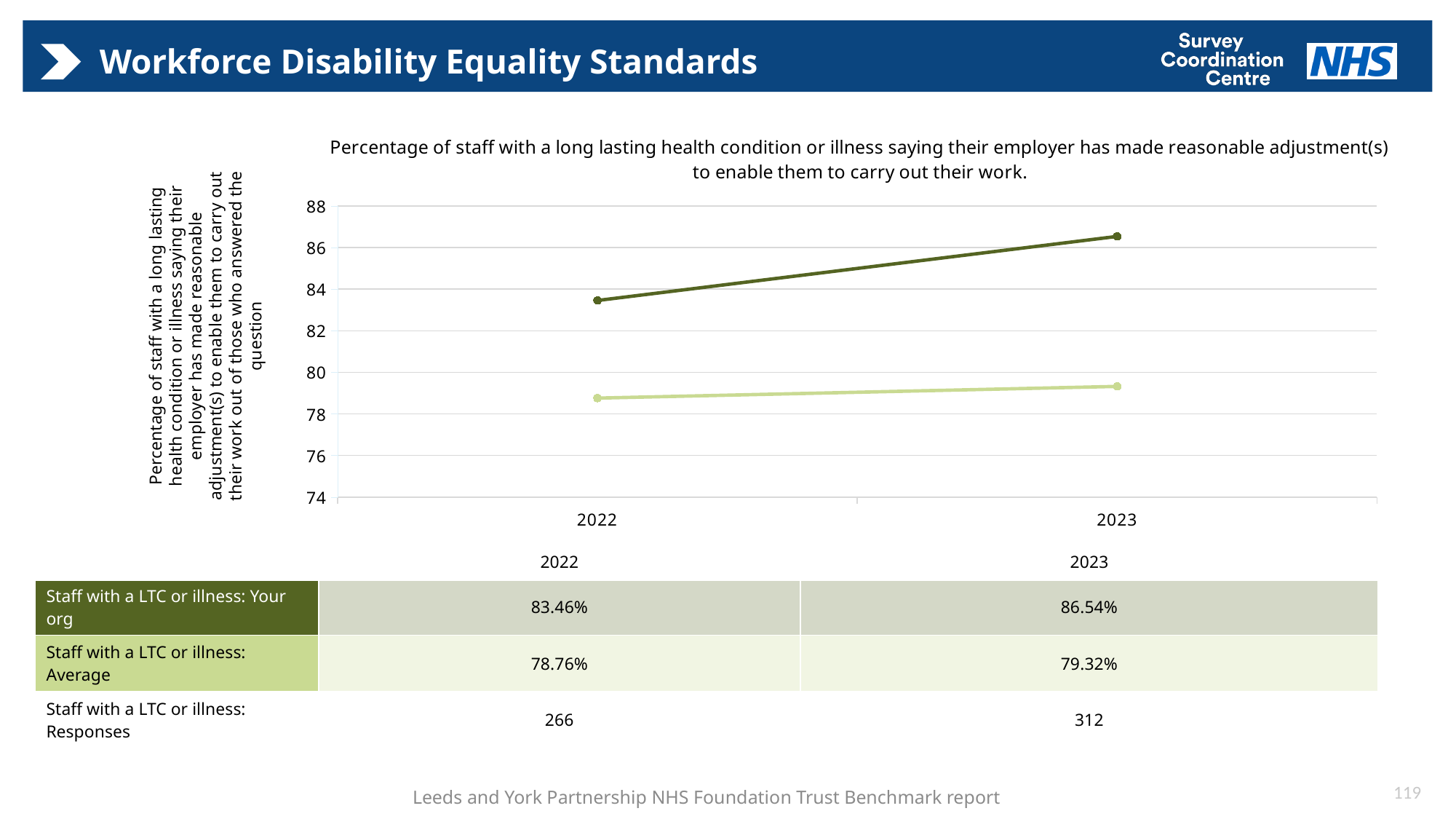
What is the value for 'Staff with a LTC or illness: Your org' in 2022? 83.46% How many responses were there for 'Staff with a LTC or illness' in 2023? 312 What is the value for 'Staff with a LTC or illness: Average' in 2023? 79.32% What is the value for 'Staff with a LTC or illness: Average' in 2022? 78.76% How many years are plotted on the x axis? 2 What is the value for 'Staff with a LTC or illness: Your org' in 2023? 86.54% Does the 'Your org' line rise or fall from 2022 to 2023? rise Is the 'Average' value for 2023 greater or less than 80? less Which series has the higher value in 2023, 'Your org' or 'Average'? Your org What kind of chart is shown on the slide? line chart What is the difference between the 'Your org' values for 2023 and 2022? 3.08% What is the difference between the 'Your org' value and the 'Average' value in 2022? 4.70%